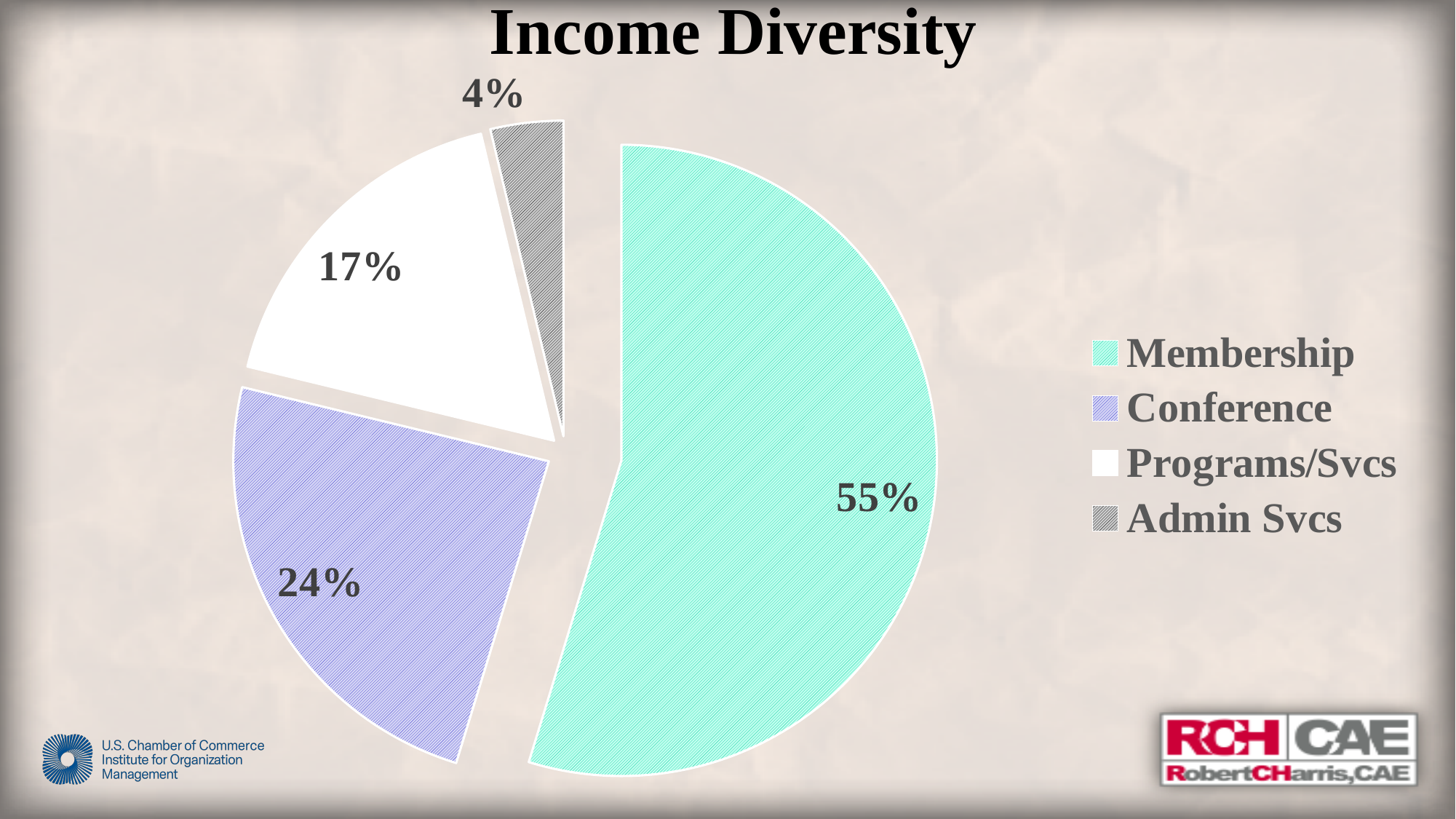
What percentage is shown for Admin Svcs? 4% Which income source has the largest share? Membership What type of chart is shown on the slide? Pie chart Which income source has the smallest share? Admin Svcs What is the difference in percentage points between Membership and Conference? 31 What percentage of income comes from Conference? 24% Which is larger, the Conference share or the Programs/Svcs share? Conference What share of income does Membership account for? 55% How many entries does the legend list? 4 What is the value shown for Programs/Svcs? 17% How many slices does the pie chart have? 4 What is the title of the chart? Income Diversity